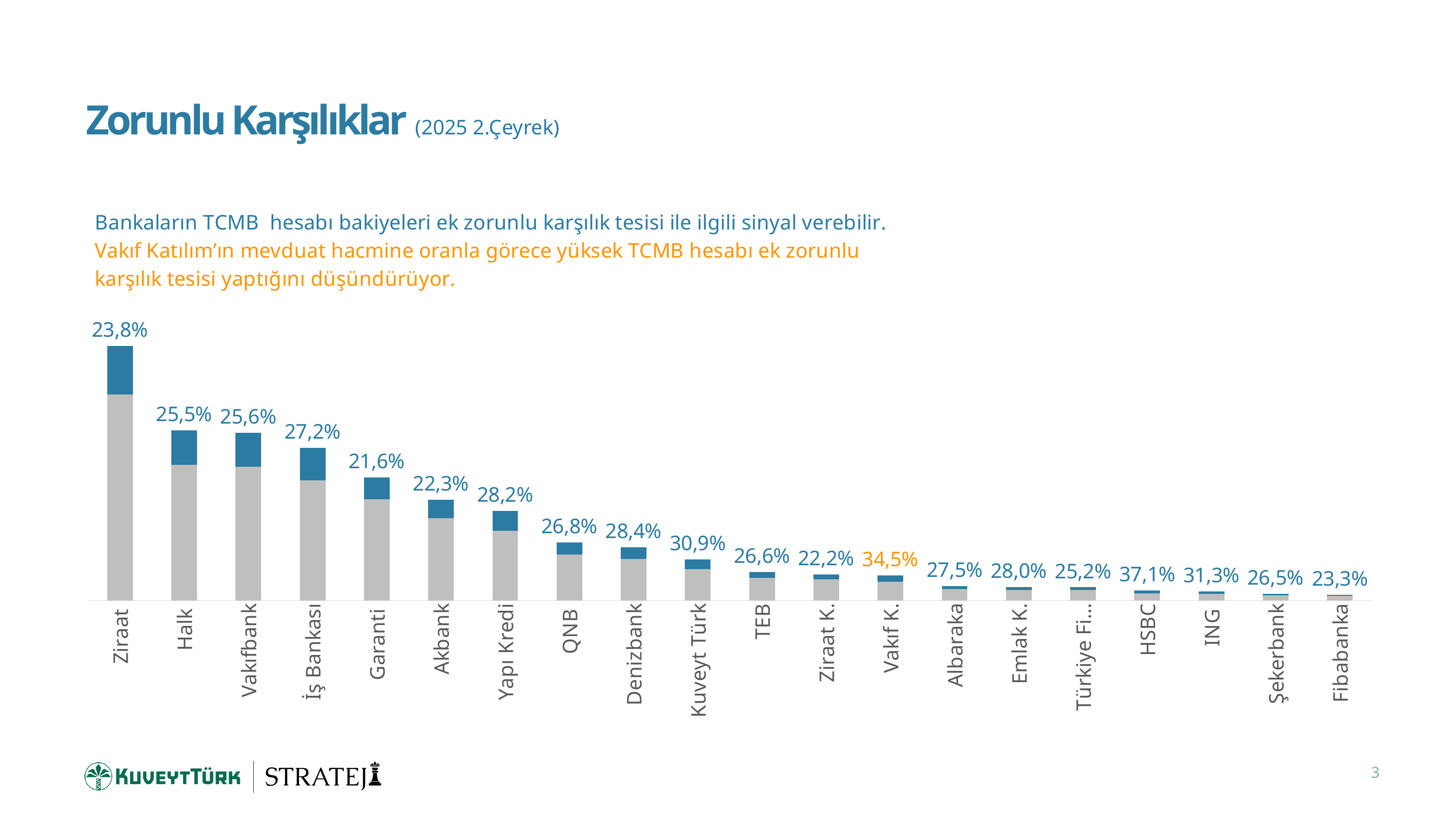
What is the difference in percentage points between the labels for Vakıf K. (34,5%) and Kuveyt Türk (30,9%)? 3,6 percentage points How many banks are shown on the x axis of the chart? 20 What percentage is shown above the bar for Vakıf K.? 34,5% Which has the larger percentage label, Halk or İş Bankası? İş Bankası What percentage is shown above the bar for HSBC? 37,1% What percentage is shown above the bar for Kuveyt Türk? 30,9% Which bank has the lowest percentage label on the chart? Garanti What kind of chart is shown on the slide? Stacked bar chart Which bank has the highest percentage label on the chart? HSBC Which bank has the tallest bar on the chart? Ziraat What percentage is shown above the bar for Ziraat? 23,8% Which bank's percentage label is printed in orange instead of blue? Vakıf K.